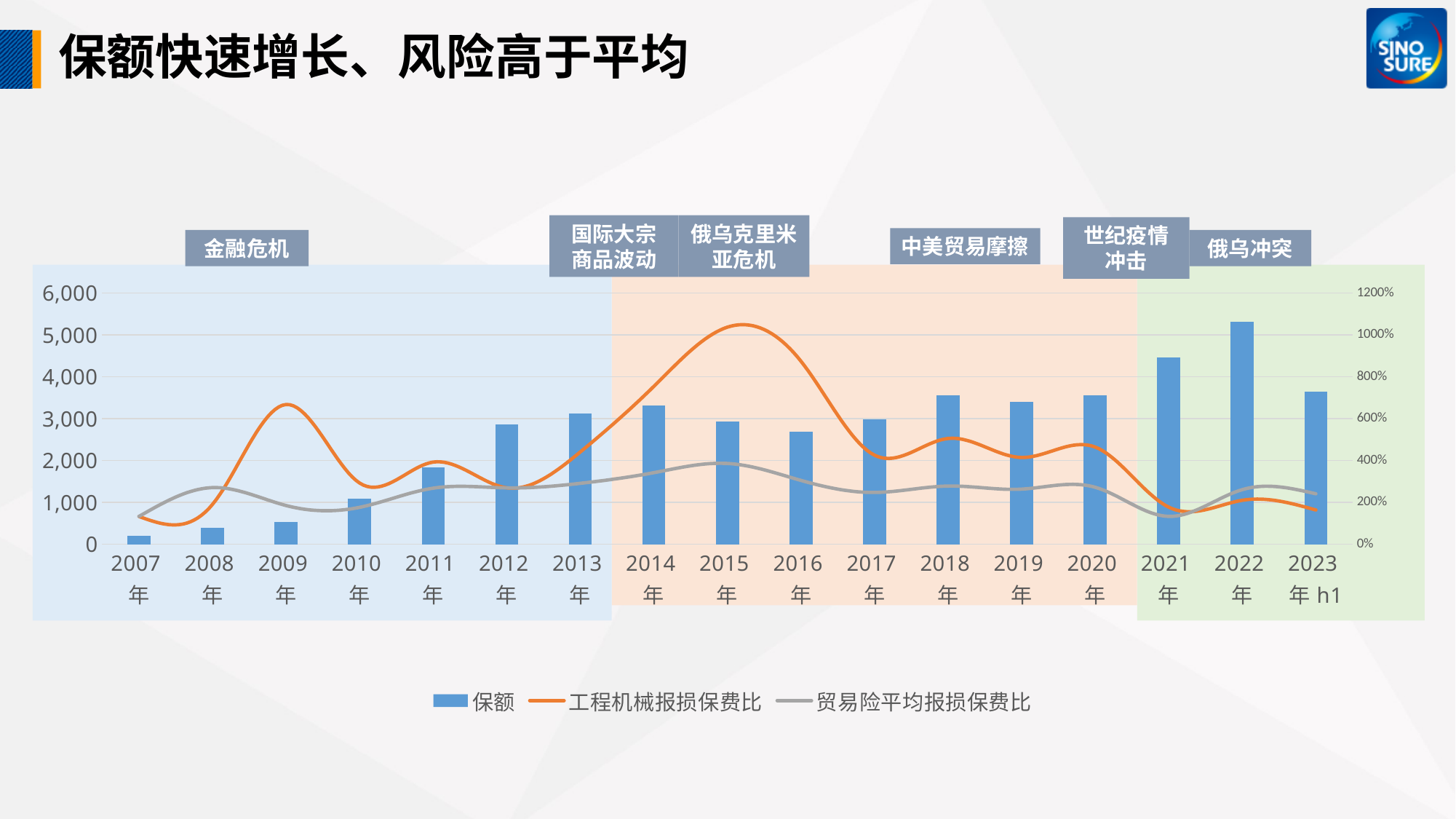
What kind of chart is shown on the slide? A combined bar and line chart Do the 保额 bars rise or fall from 2007年 to 2013年? Rise How many year categories are shown on the x axis? 17 In which year is the 保额 bar the highest? 2022年 In which year does the 工程机械报损保费比 line reach its peak? 2015年 Is the 保额 value for 2007年 greater or less than 1,000? less Is the 保额 value for 2022年 greater or less than 5,000? greater What is the title of the slide? 保额快速增长、风险高于平均 In which year is the 保额 bar the lowest? 2007年 How many series does the legend list? 3 Which year has the larger 保额 bar, 2014年 or 2016年? 2014年 Is the 保额 value for 2021年 greater or less than 4,000? greater